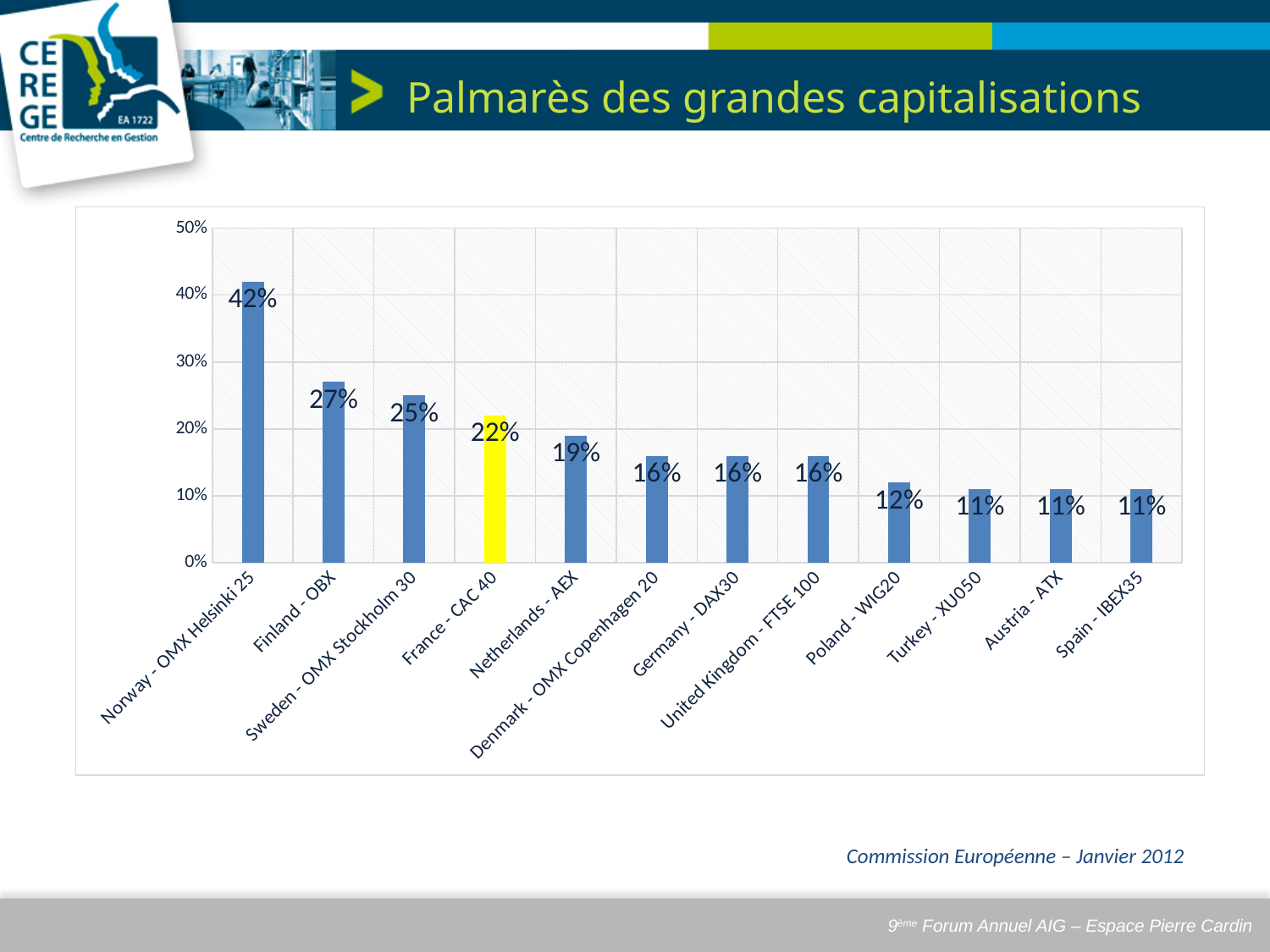
What is the value for France - CAC 40? 22% What is the value for Norway - OMX Helsinki 25? 42% Which bar is highlighted in yellow? France - CAC 40 What is the difference between the values for Norway - OMX Helsinki 25 and Finland - OBX? 15% What is the value for Netherlands - AEX? 19% What kind of chart is shown on the slide? Bar chart Which category has the highest value? Norway - OMX Helsinki 25 What is the value for Poland - WIG20? 12% How many categories are shown on the x axis? 12 Which is larger, the value for Finland - OBX or the value for Germany - DAX30? Finland - OBX Is the value for Sweden - OMX Stockholm 30 greater or less than 20%? greater What is the difference between the values for Sweden - OMX Stockholm 30 and France - CAC 40? 3%